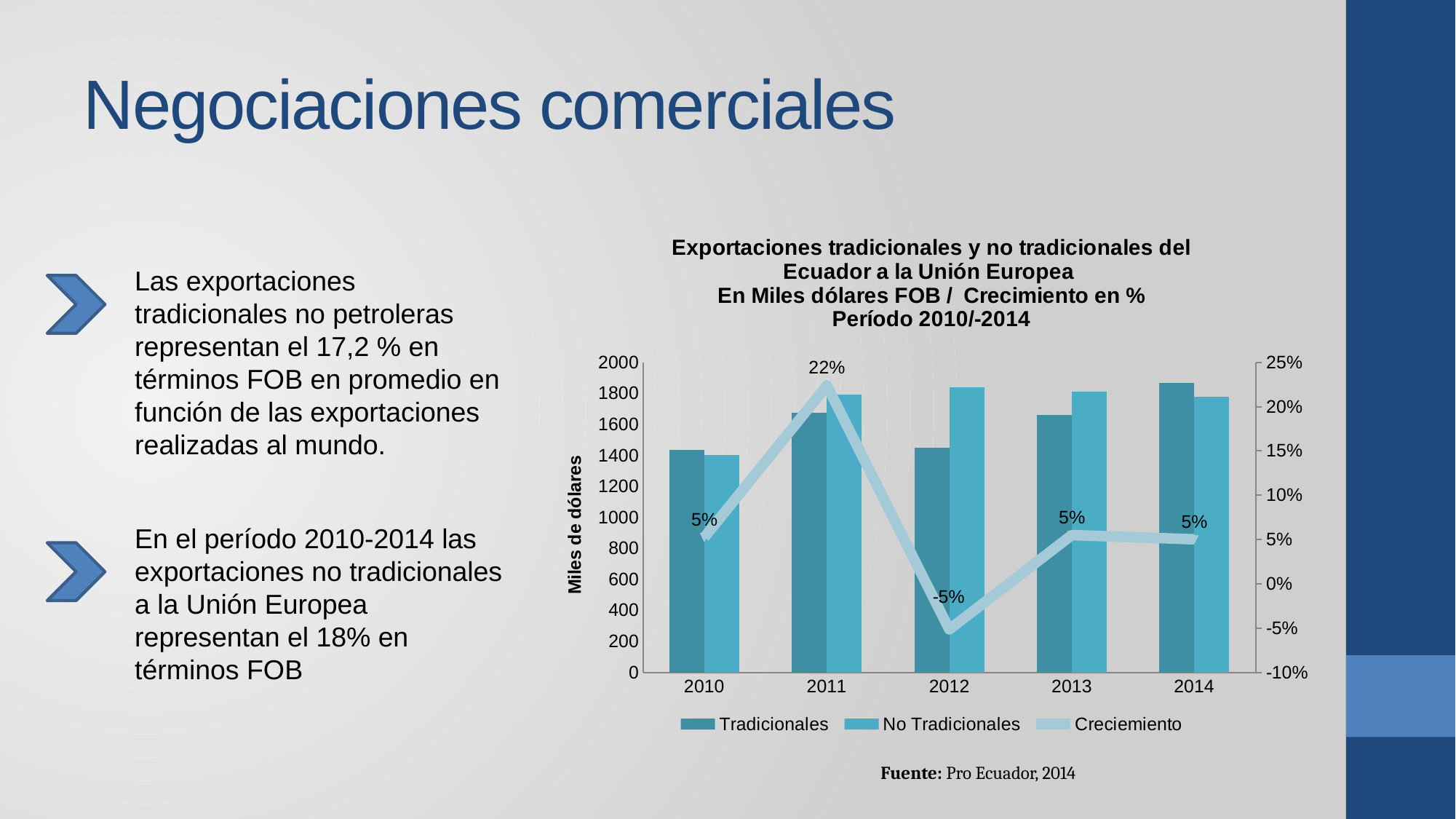
How many series does the chart legend list? 3 In which year is the Creciemiento line at its highest? 2011 How many years are shown on the x axis of the chart? 5 What is the title of the left vertical axis of the chart? Miles de dólares What is the Creciemiento value shown for 2011? 22% What is the difference between the Creciemiento values for 2011 and 2012? 27 percentage points What is the Creciemiento value shown for 2010? 5% What is the Creciemiento value shown for 2012? -5% In which year is the Creciemiento line at its lowest? 2012 In 2012, which bar is taller: Tradicionales or No Tradicionales? No Tradicionales Is the Tradicionales bar for 2014 greater or less than 1800? greater Is the Tradicionales bar for 2012 greater or less than 1600? less